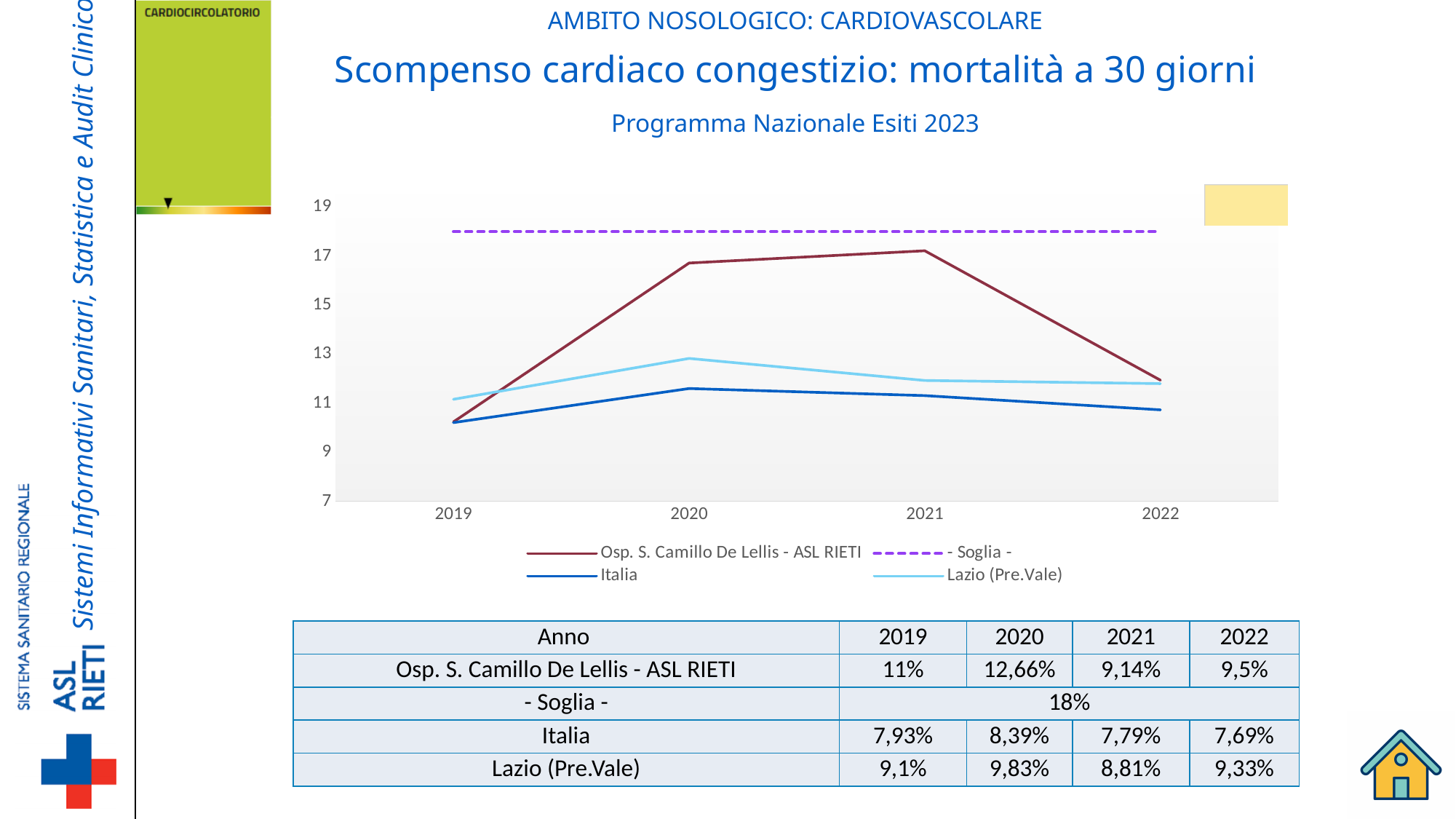
Which series in the chart is drawn as a dashed line? - Soglia - How many series does the chart legend list? 4 Is the value for Osp. S. Camillo De Lellis - ASL RIETI in 2020 greater or less than 15? greater Does the Osp. S. Camillo De Lellis - ASL RIETI line rise or fall from 2021 to 2022? fall Is the value for Osp. S. Camillo De Lellis - ASL RIETI in 2019 greater or less than 11? less In 2020, which is larger: the value for Osp. S. Camillo De Lellis - ASL RIETI or the value for Italia? Osp. S. Camillo De Lellis - ASL RIETI In which year does the Italia line reach its highest value? 2020 In which year does the Osp. S. Camillo De Lellis - ASL RIETI line reach its lowest value? 2019 Is the value for Lazio (Pre.Vale) in 2020 greater or less than 12? greater What kind of chart is shown on the slide? line chart In which year does the Lazio (Pre.Vale) line reach its highest value? 2020 How many years are shown on the x axis of the chart? 4